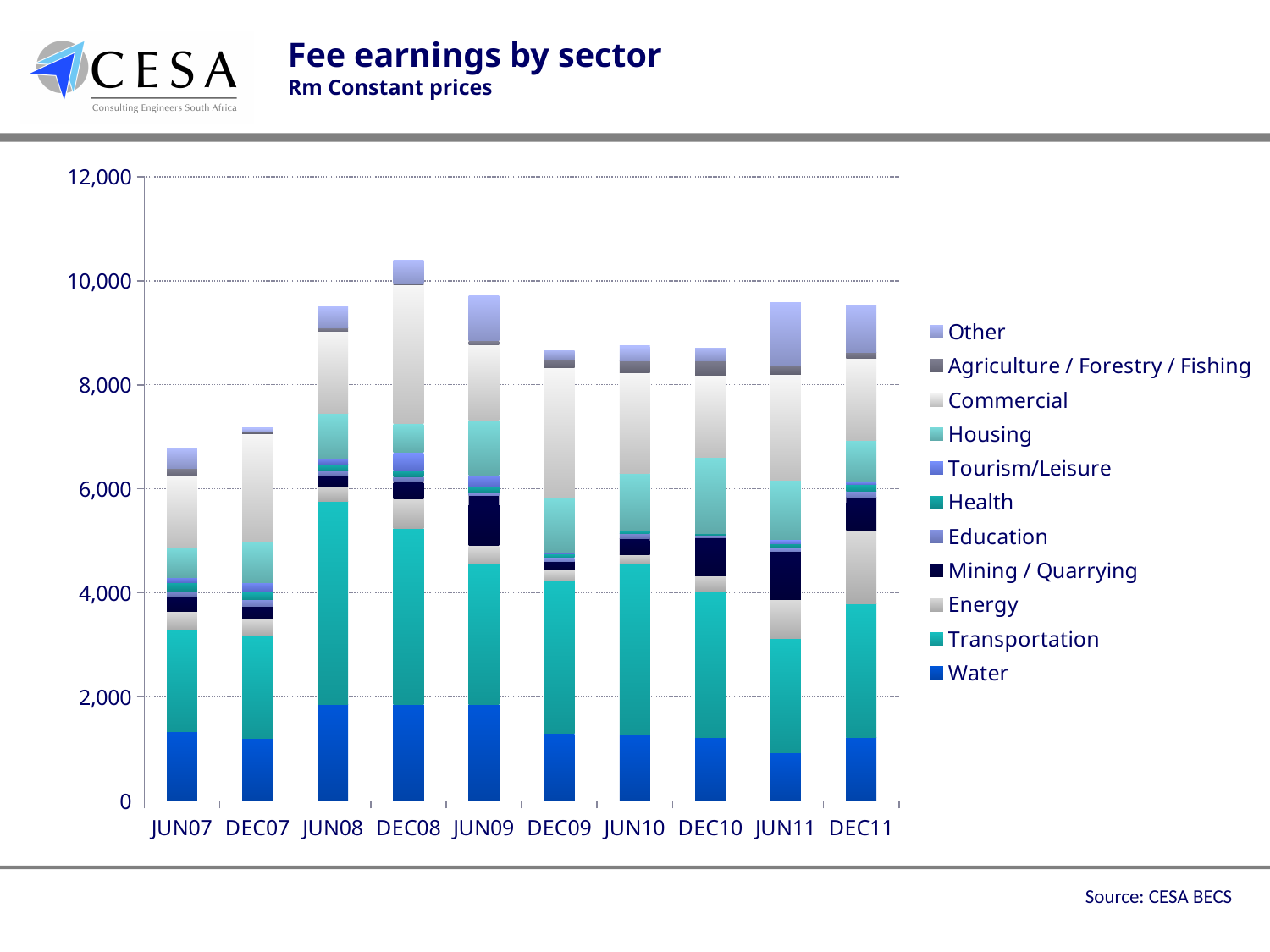
Do total fee earnings rise or fall from JUN07 to DEC08? rise What is the title of the chart? Fee earnings by sector Which period has the highest total fee earnings? DEC08 Which period has the lowest total fee earnings? JUN07 Is the total fee earnings for DEC08 greater or less than 10,000? greater What kind of chart is shown on the slide? stacked bar chart What source is cited for the chart? CESA BECS How many sectors does the legend list? 11 How many time periods are shown on the x axis? 10 Which period has the larger Water value, JUN08 or JUN11? JUN08 Is the total fee earnings for JUN07 greater or less than 8,000? less